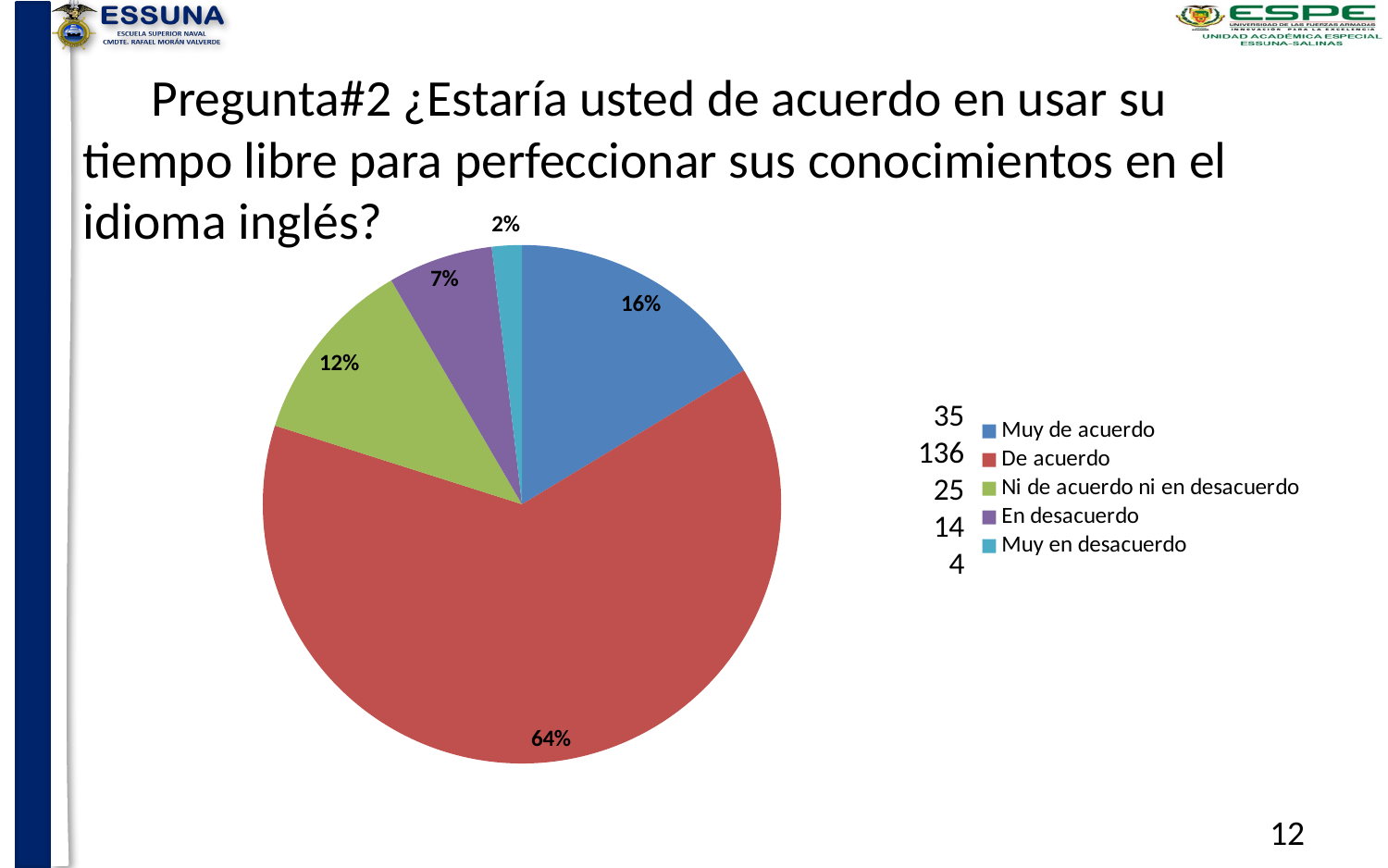
What kind of chart is shown on the slide? pie chart How many categories does the pie chart have? 5 What percentage of the pie does the "Ni de acuerdo ni en desacuerdo" slice represent? 12% What percentage of the pie does the "Muy en desacuerdo" slice represent? 2% Which slice is larger, "Muy de acuerdo" or "Ni de acuerdo ni en desacuerdo"? Muy de acuerdo Which category has the smallest slice of the pie? Muy en desacuerdo What colour is the "De acuerdo" slice in the pie chart? red What percentage of the pie does the "Muy de acuerdo" slice represent? 16% Which category has the largest slice of the pie? De acuerdo What is the difference in percentage points between the "De acuerdo" slice and the "Muy de acuerdo" slice? 48%